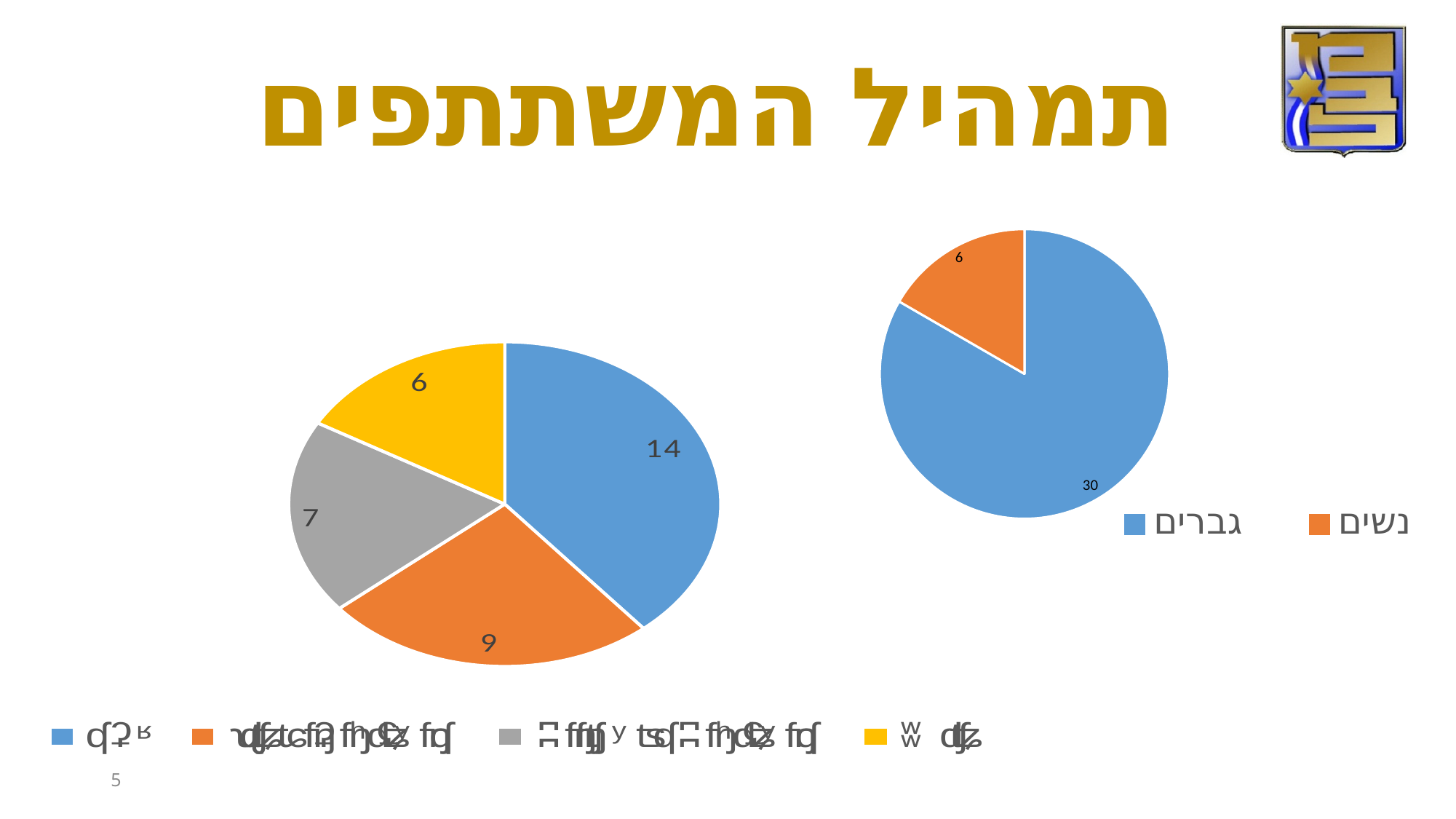
In the pie chart on the right, which category has the larger value, גברים or נשים? גברים In the pie chart on the left, what is the value of the blue slice? 14 In the pie chart on the left, what is the difference between the orange slice and the gray slice? 2 In the pie chart on the left, what is the value of the smallest slice? 6 What kind of chart is the chart on the right of the slide? pie chart In the pie chart on the left, how many slices are there? 4 In the pie chart on the right, what is the value for נשים? 6 In the pie chart on the right, what is the total of all slices? 36 In the pie chart on the right, how many categories does the legend list? 2 In the pie chart on the right, what is the value for גברים? 30 What kind of chart is the chart on the left of the slide? pie chart In the pie chart on the right, what is the difference between the values for גברים and נשים? 24